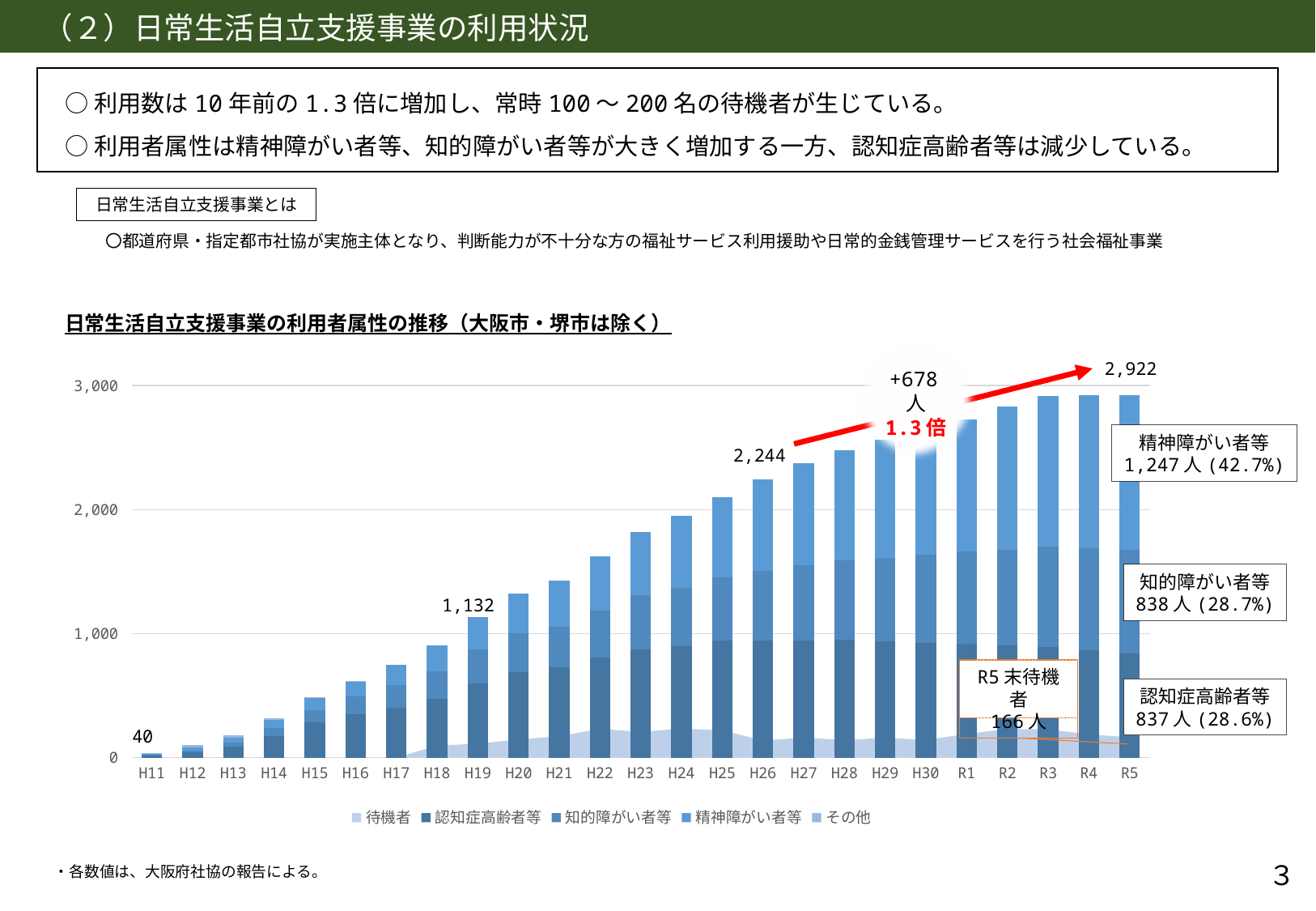
How many years (categories) are shown on the x axis? 25 What share of R5 users are 知的障がい者等? 28.7% How many 認知症高齢者等 users are shown for R5? 837人 Is the total for H23 greater or less than 2,000? less What is the total number of users shown for H19? 1,132 What is the total number of users shown for H11? 40 What is the total number of users shown for R5? 2,922 How many series does the legend list? 5 Which year has the lowest total number of users? H11 How many 精神障がい者等 users are shown for R5? 1,247人